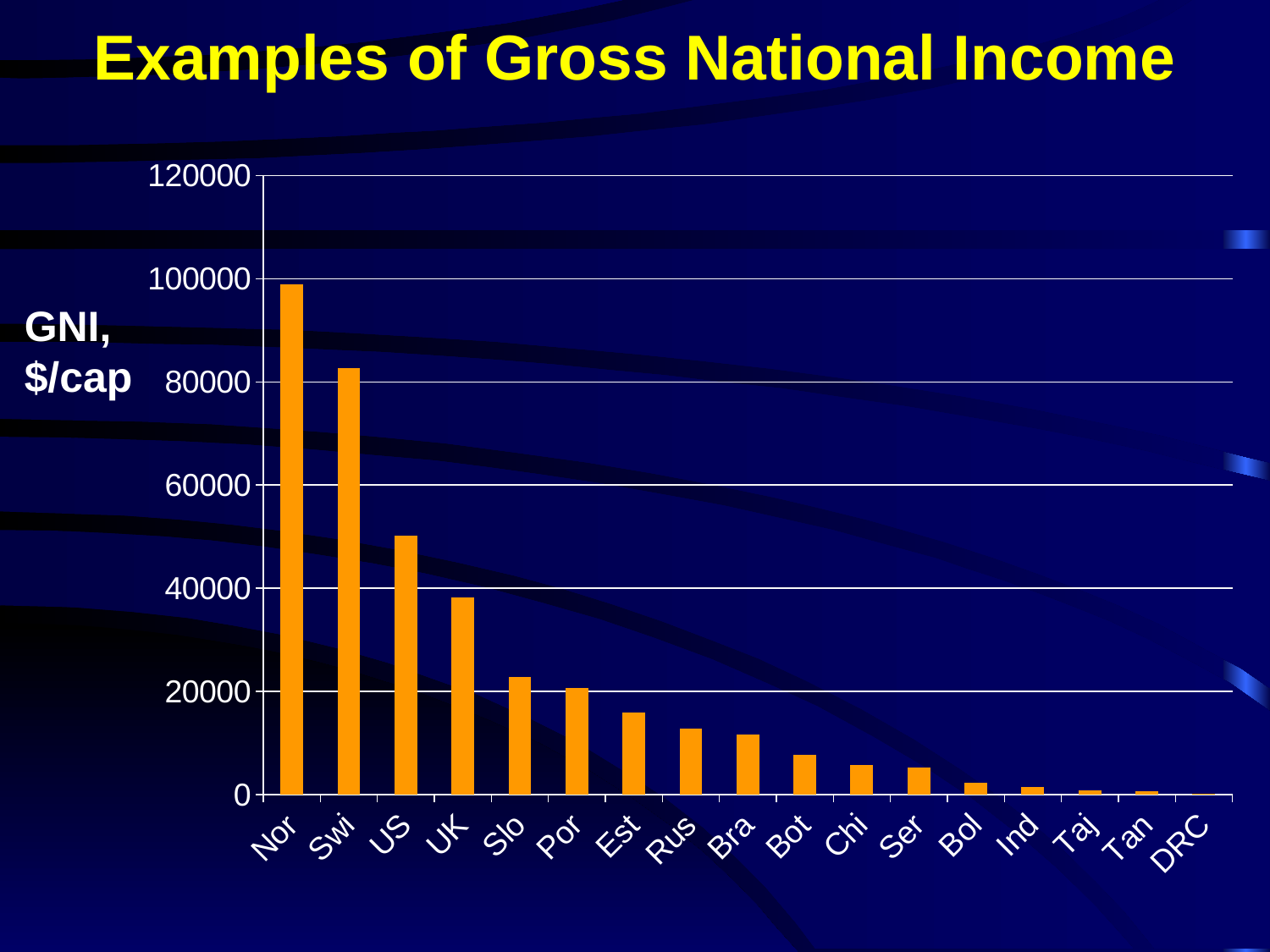
Do the bar values rise or fall from left to right along the x axis? fall Is the value for Bot greater or less than 10000? less Is the value for Nor greater or less than 80000? greater Which country has the lowest GNI per capita in the chart? DRC What kind of chart is shown on the slide? bar chart What is the title of the chart? Examples of Gross National Income Is the value for US greater or less than 60000? less How many countries are plotted in the chart? 17 Which country has the highest GNI per capita in the chart? Nor Which has a larger GNI per capita, US or UK? US